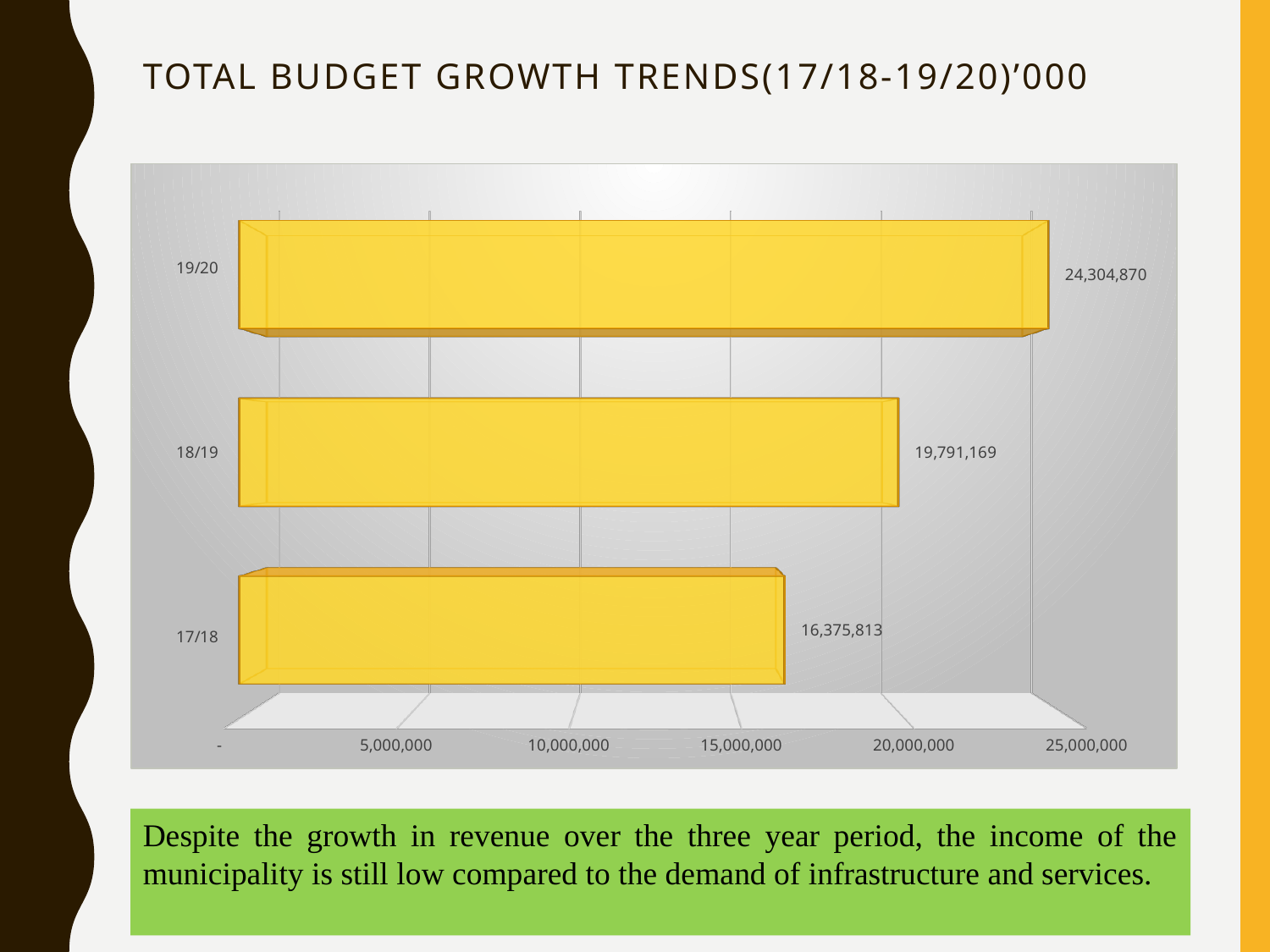
What is the value for 18/19? 19,791,169 What is the difference between the values for 18/19 and 17/18? 3,415,356 What is the value for 19/20? 24,304,870 Which is larger, the value for 18/19 or the value for 17/18? 18/19 What is the value for 17/18? 16,375,813 What is the difference between the values for 19/20 and 18/19? 4,513,701 Is the value for 17/18 greater or less than 15,000,000? greater Which year has the highest total budget? 19/20 Do the budget values rise or fall from 17/18 to 19/20? rise What kind of chart is shown on the slide? bar chart How many years are shown in the chart? 3 Which year has the lowest total budget? 17/18